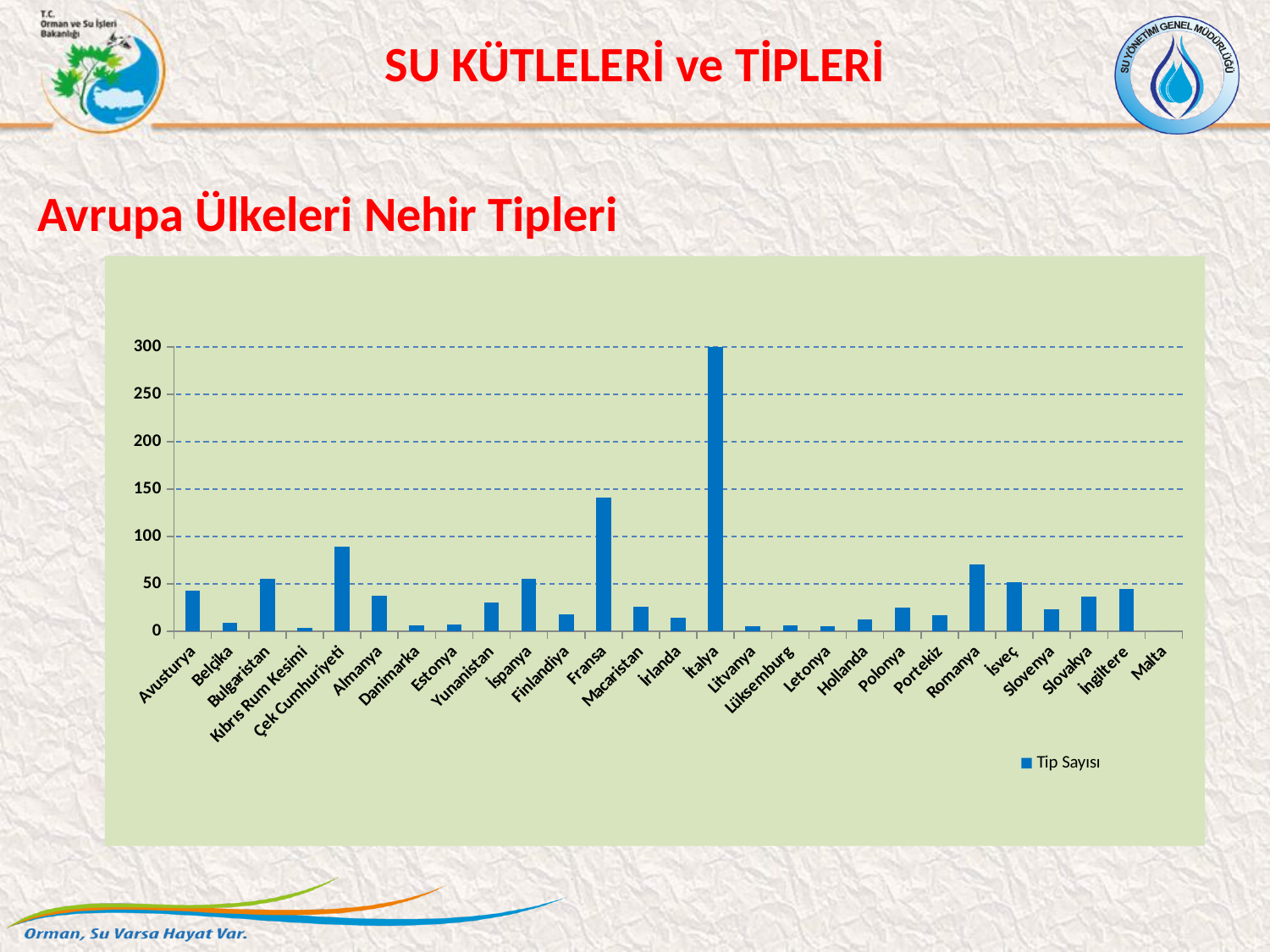
Which has a larger value, Romanya or İsveç? Romanya Is the value for Romanya greater or less than 50? greater Is the value for Fransa greater or less than 100? greater Is the value for Çek Cumhuriyeti greater or less than 100? less Which country has the highest number of river types in the chart? İtalya What kind of chart is shown on the slide? bar chart How many countries are shown on the x axis of the chart? 27 Which country has the lowest value in the chart? Malta What is the legend entry of the chart? Tip Sayısı How many series does the legend list? 1 What is the title shown above the chart? Avrupa Ülkeleri Nehir Tipleri Which has a larger value, Fransa or Çek Cumhuriyeti? Fransa